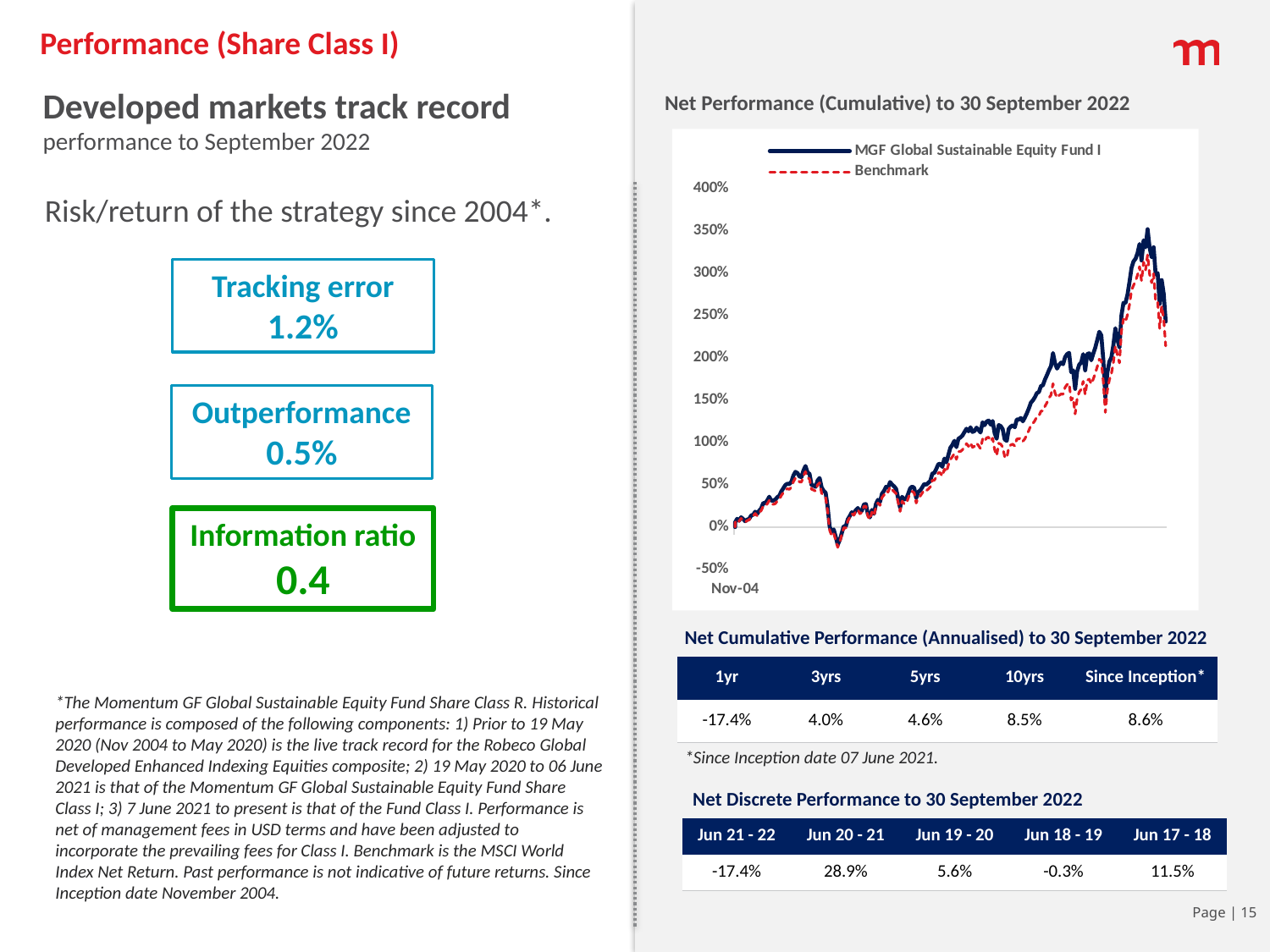
In the Net Performance (Cumulative) chart, is the lowest point of the MGF Global Sustainable Equity Fund I line greater or less than 0%? less How many series does the legend of the Net Performance (Cumulative) chart list? 2 In the Net Performance (Cumulative) chart, do the cumulative returns overall rise or fall from Nov-04 to September 2022? rise In the Net Performance (Cumulative) chart, which series is drawn as a red dashed line? Benchmark What is the title of the chart on the right of the slide? Net Performance (Cumulative) to 30 September 2022 In the Net Performance (Cumulative) chart, is the peak value of the MGF Global Sustainable Equity Fund I line greater or less than 300%? greater What kind of chart is shown under 'Net Performance (Cumulative) to 30 September 2022'? Line chart In the Net Performance (Cumulative) chart, is the peak value of the Benchmark line greater or less than 300%? greater In the Net Performance (Cumulative) chart, which series ends higher at the right-hand end of the chart: MGF Global Sustainable Equity Fund I or Benchmark? MGF Global Sustainable Equity Fund I